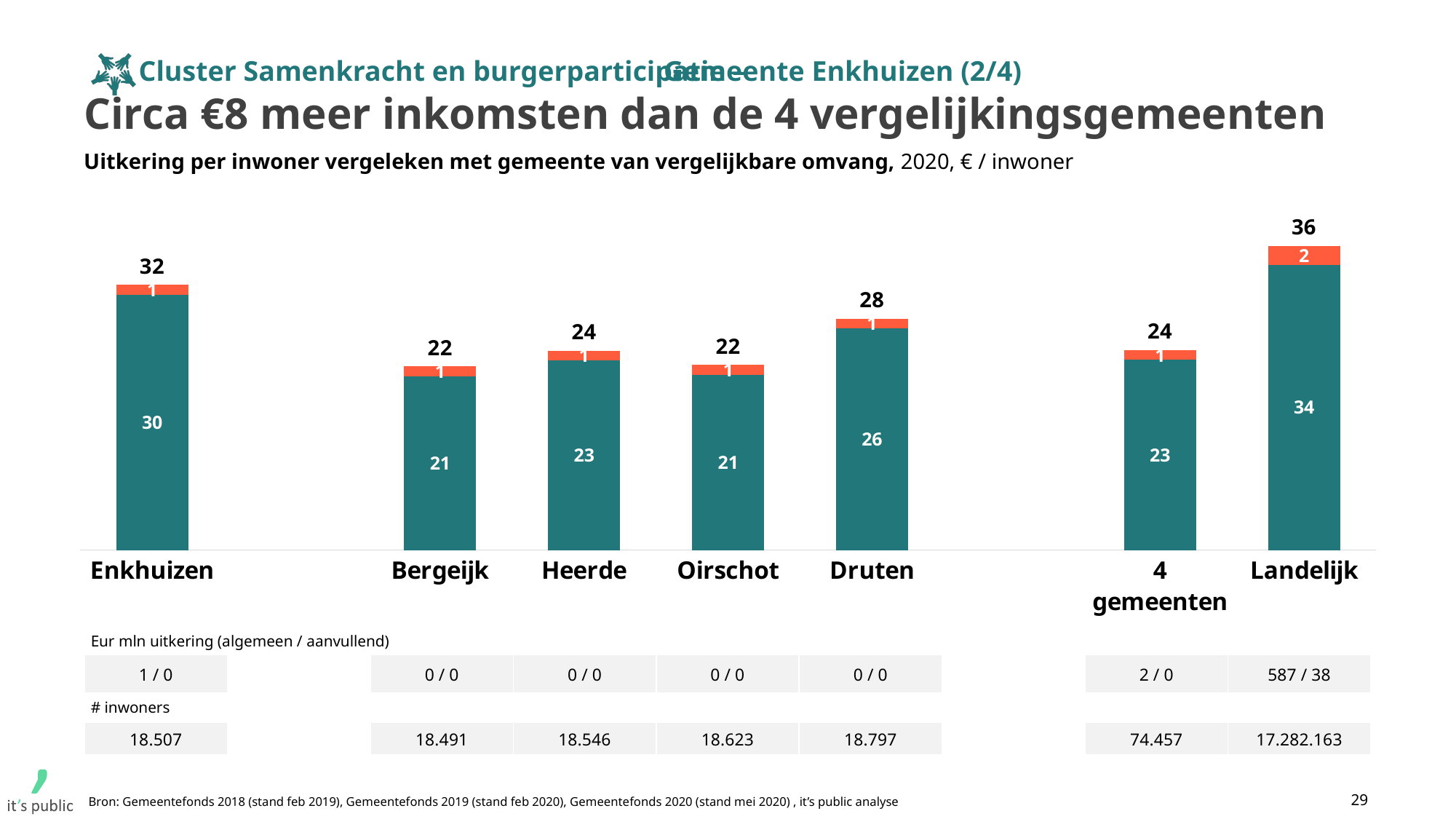
What is the total value shown above the bar for Enkhuizen? 32 What is the number of inhabitants (# inwoners) listed for Enkhuizen below the chart? 18.507 What is the difference between the total for Enkhuizen and the total for 4 gemeenten? 8 What is the total value shown above the bar for 4 gemeenten? 24 What is the value of the teal (lower) segment for Druten? 26 Which category has the highest total value? Landelijk What is the value of the orange (upper) segment for Landelijk? 2 Which category has the lowest teal (lower) segment value? Bergeijk and Oirschot What kind of chart is shown on the slide? Stacked bar chart Which has a larger total value, Druten or Heerde? Druten What is the total of the stacked bar for Landelijk? 36 How many categories are shown on the x axis of the chart? 7